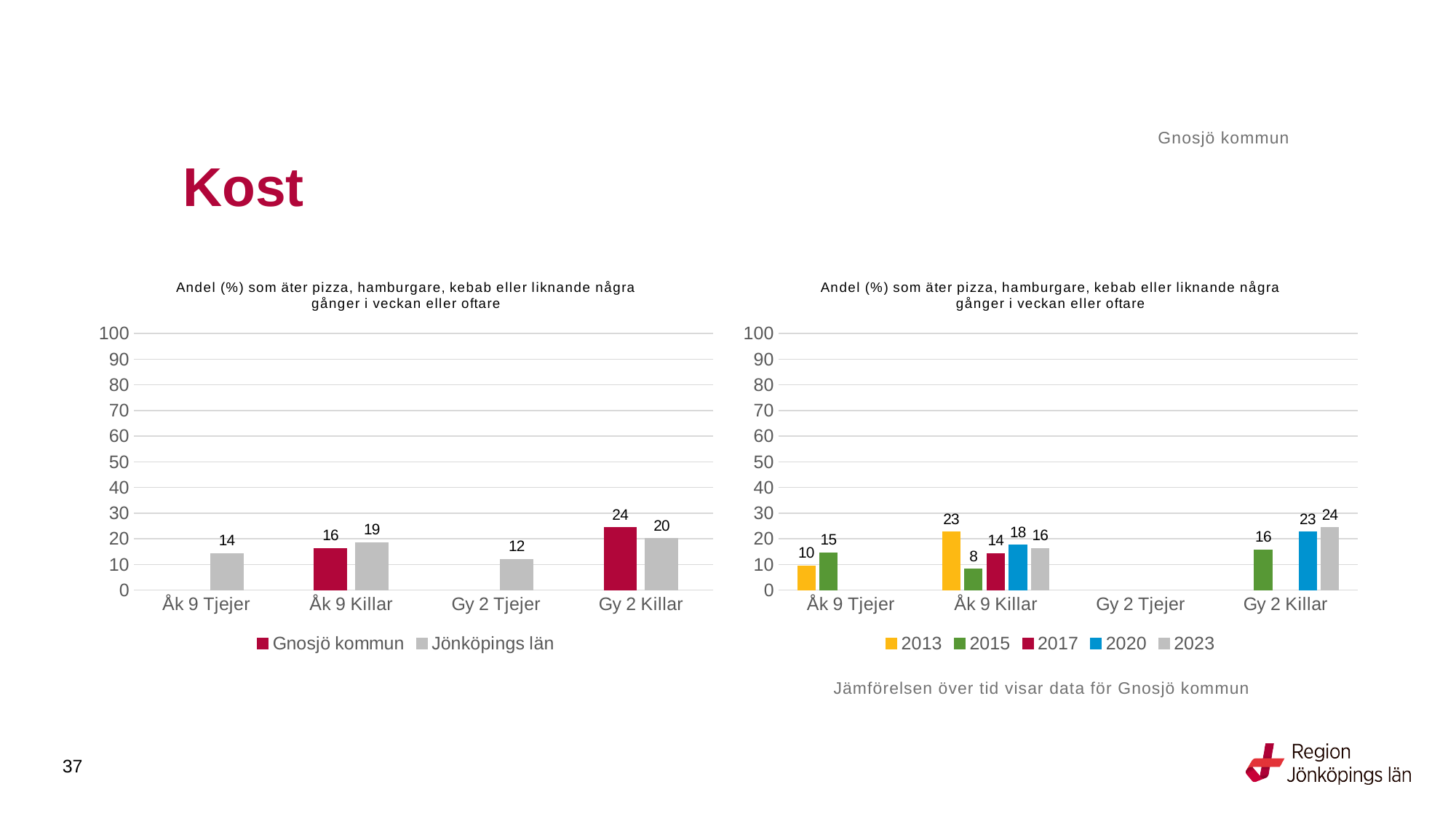
In the left chart, what is the value for Gnosjö kommun for Åk 9 Killar? 16 In the left chart, which is larger for Åk 9 Killar: Gnosjö kommun or Jönköpings län? Jönköpings län In the right chart, how many series does the legend list? 5 In the right chart, which year has the lowest value for Åk 9 Killar? 2015 In the left chart, what is the value for Jönköpings län for Gy 2 Killar? 20 In the right chart, what is the value for 2020 for Gy 2 Killar? 23 In the right chart, what is the value for 2013 for Åk 9 Killar? 23 In the left chart, how many series does the legend list? 2 What type of chart is the right chart? Bar chart In the left chart, which category has the lowest value for Jönköpings län? Gy 2 Tjejer In the left chart, what is the difference between Gnosjö kommun and Jönköpings län for Gy 2 Killar? 4 In the right chart, what is the difference between 2015 and 2013 for Åk 9 Tjejer? 5